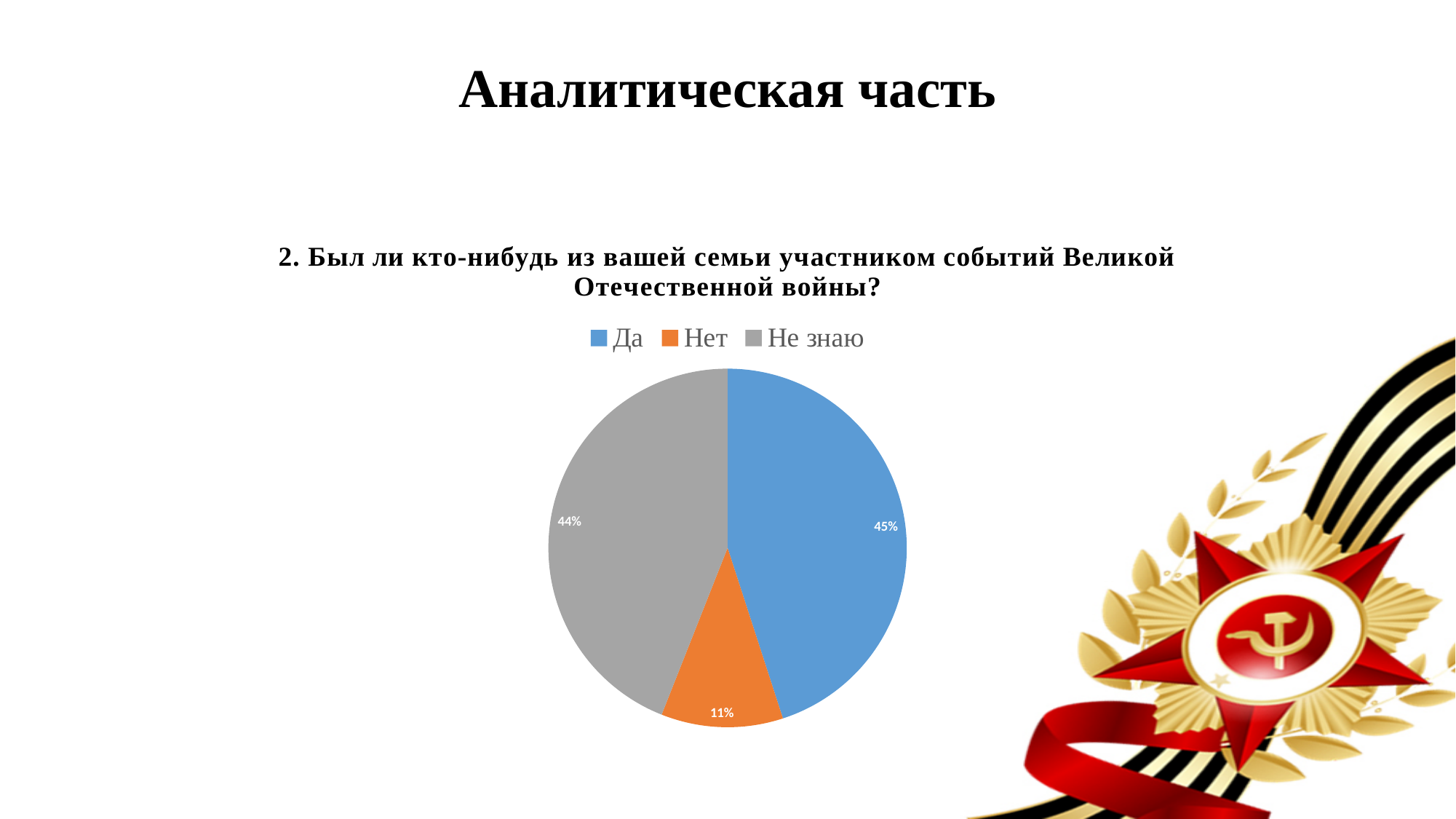
How many slices does the pie chart have? 3 What percentage of respondents answered "Да"? 45% What kind of chart is shown on the slide? pie chart Which is larger, the share for "Нет" or the share for "Не знаю"? Не знаю Which answer has the smallest share of the pie? Нет What percentage of respondents answered "Нет"? 11% What percentage of respondents answered "Не знаю"? 44% What is the difference in percentage points between the "Да" and "Не знаю" slices? 1% What colour is the "Нет" slice in the pie chart? orange What is the difference in percentage points between the "Да" and "Нет" slices? 34% Which answer has the largest share of the pie? Да How many entries does the legend list? 3